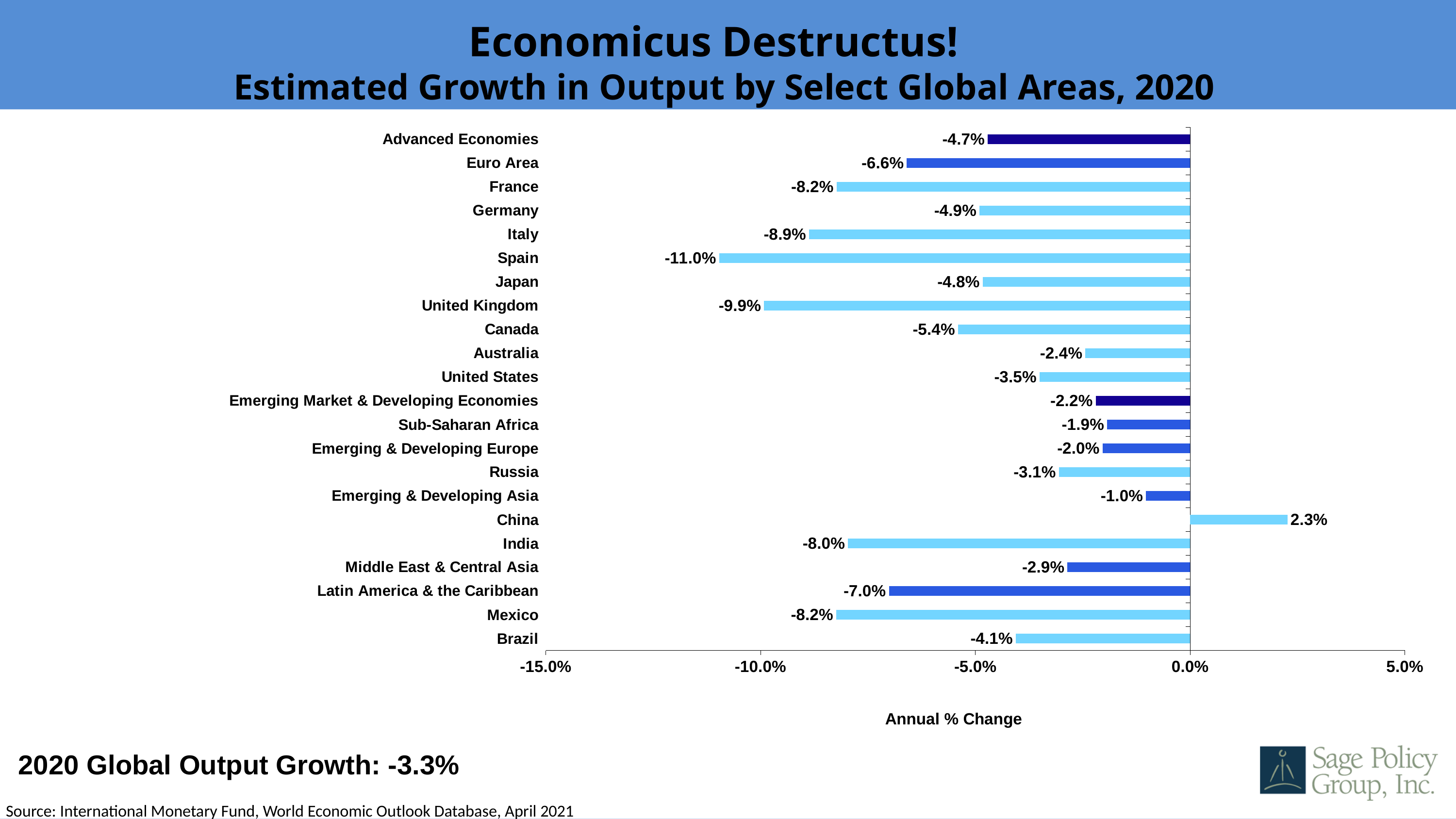
What is the difference between the estimated 2020 output growth of the United Kingdom and Canada? 4.5 percentage points What is the estimated 2020 output growth for Spain? -11.0% Which area has the lowest estimated 2020 output growth? Spain What is the estimated 2020 output growth for China? 2.3% What is the label on the horizontal axis of the chart? Annual % Change What is the estimated 2020 output growth for the United States? -3.5% How many global areas are shown in the chart? 22 What kind of chart is shown on the slide? Bar chart Is the value for India greater or less than -5.0%? less What is the estimated 2020 output growth for Latin America & the Caribbean? -7.0% Which has the higher estimated 2020 output growth, Germany or Italy? Germany Which area has the highest estimated 2020 output growth? China